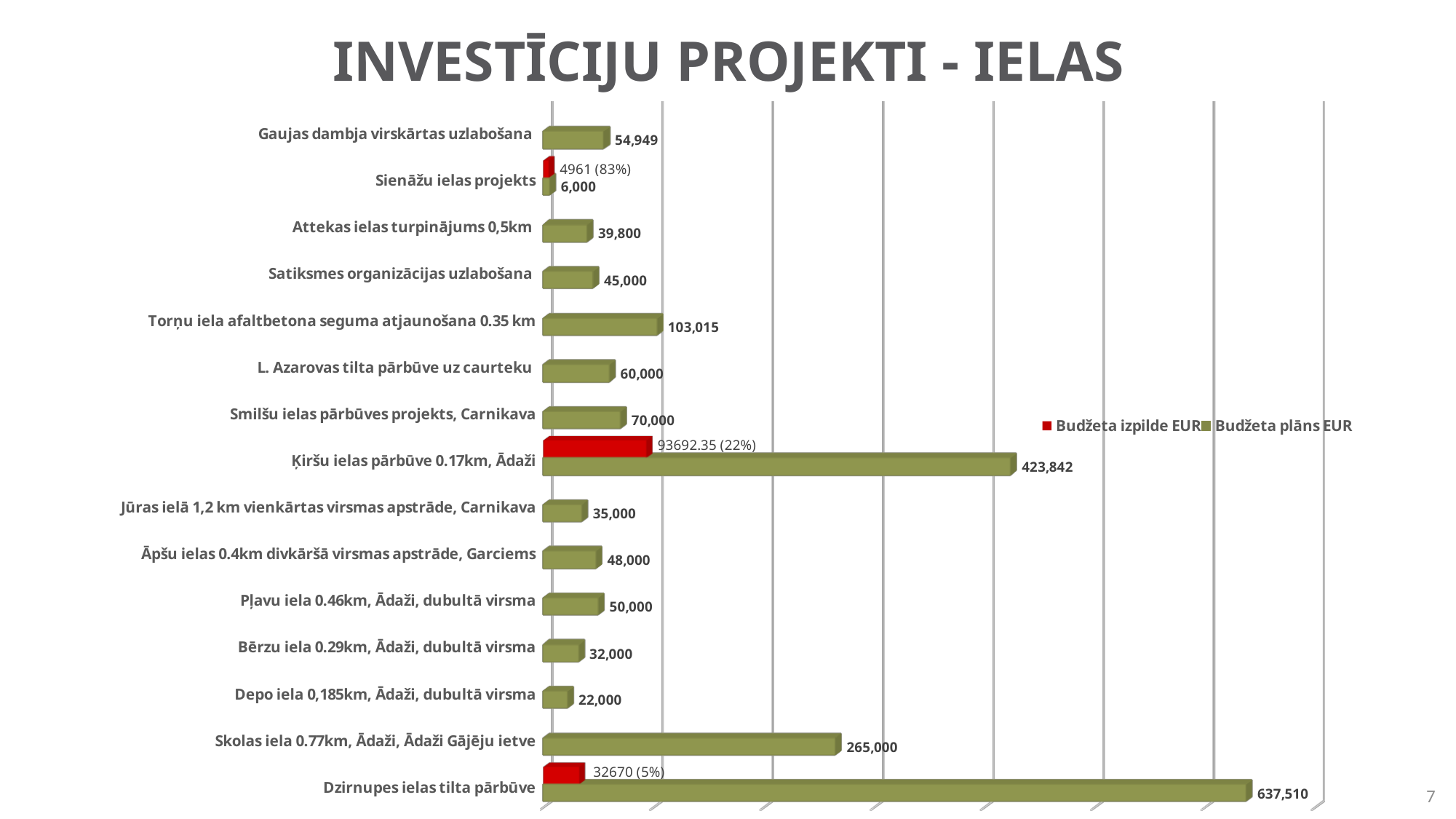
How many categories (projects) are shown on the chart? 15 What colour represents the Budžeta izpilde EUR series? Red What is the Budžeta izpilde EUR value for Ķiršu ielas pārbūve 0.17km, Ādaži? 93692.35 (22%) What is the Budžeta izpilde EUR value for Dzirnupes ielas tilta pārbūve? 32670 (5%) What kind of chart is shown on the slide? Bar chart What is the difference between the Budžeta plāns EUR values for Dzirnupes ielas tilta pārbūve and Ķiršu ielas pārbūve 0.17km, Ādaži? 213,668 Which has a larger Budžeta plāns EUR value: Smilšu ielas pārbūves projekts, Carnikava or L. Azarovas tilta pārbūve uz caurteku? Smilšu ielas pārbūves projekts, Carnikava Which project has the lowest Budžeta plāns EUR value? Sienāžu ielas projekts Which project has the highest Budžeta plāns EUR value? Dzirnupes ielas tilta pārbūve What is the Budžeta plāns EUR value for Skolas iela 0.77km, Ādaži, Ādaži Gājēju ietve? 265,000 What is the Budžeta plāns EUR value for Torņu iela afaltbetona seguma atjaunošana 0.35 km? 103,015 How many series does the legend list? 2